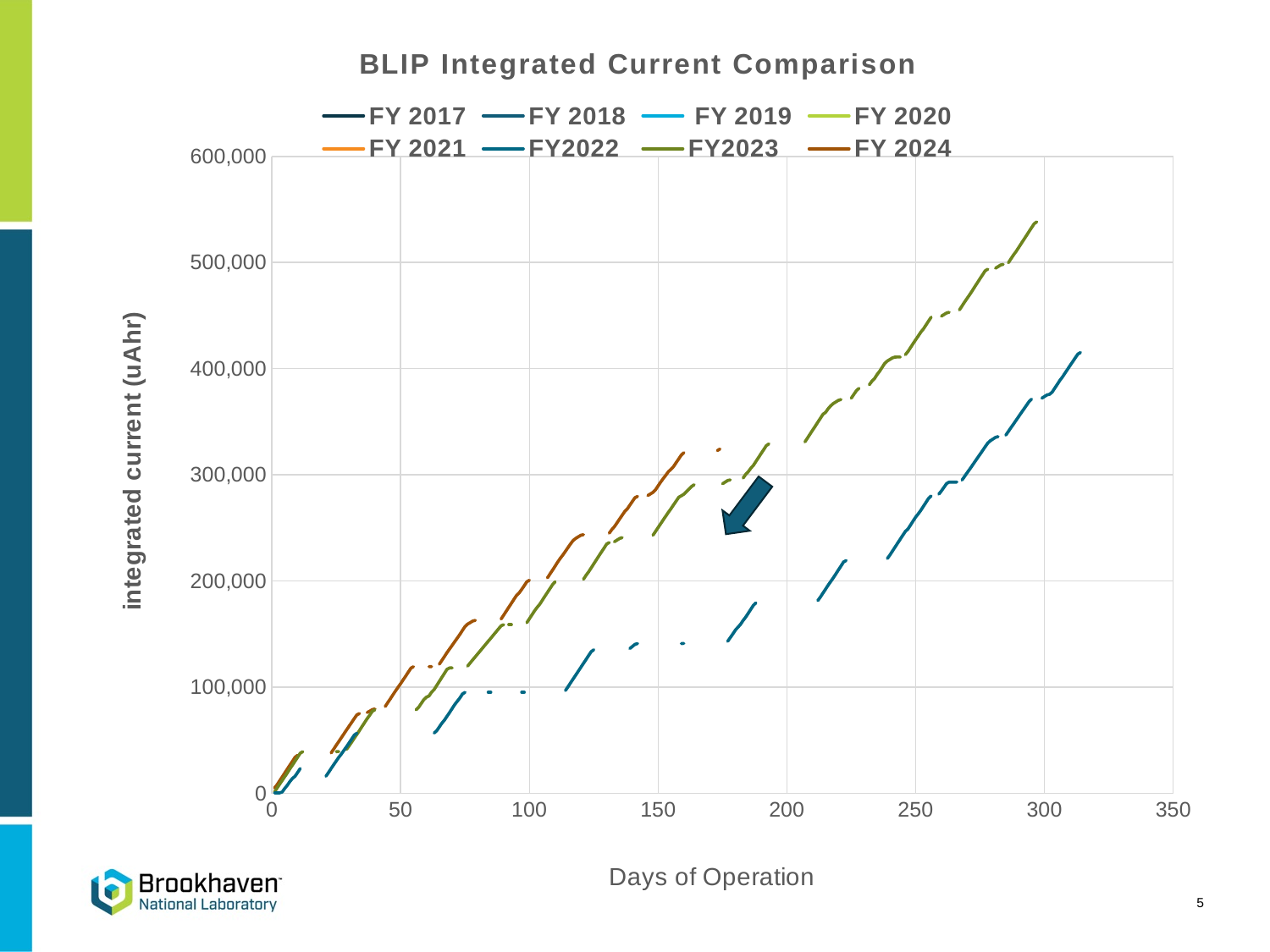
At 200 days of operation, which series has the higher integrated current, FY2023 or FY2022? FY2023 Is the final value of the FY2022 line greater or less than 400,000? greater Is the final value of the FY2023 line greater or less than 500,000? greater Is the value of the FY2022 line at 100 days of operation greater or less than 100,000? less Which series extends to the largest number of days of operation? FY2022 What is the title of the chart? BLIP Integrated Current Comparison Which series reaches the highest integrated current on the chart? FY2023 What kind of chart is shown on the slide? line chart At 150 days of operation, which series has the higher integrated current, FY 2024 or FY2023? FY 2024 Do the plotted values rise or fall as the days of operation increase? rise How many series does the legend list? 8 What is the label of the y axis? integrated current (uAhr)